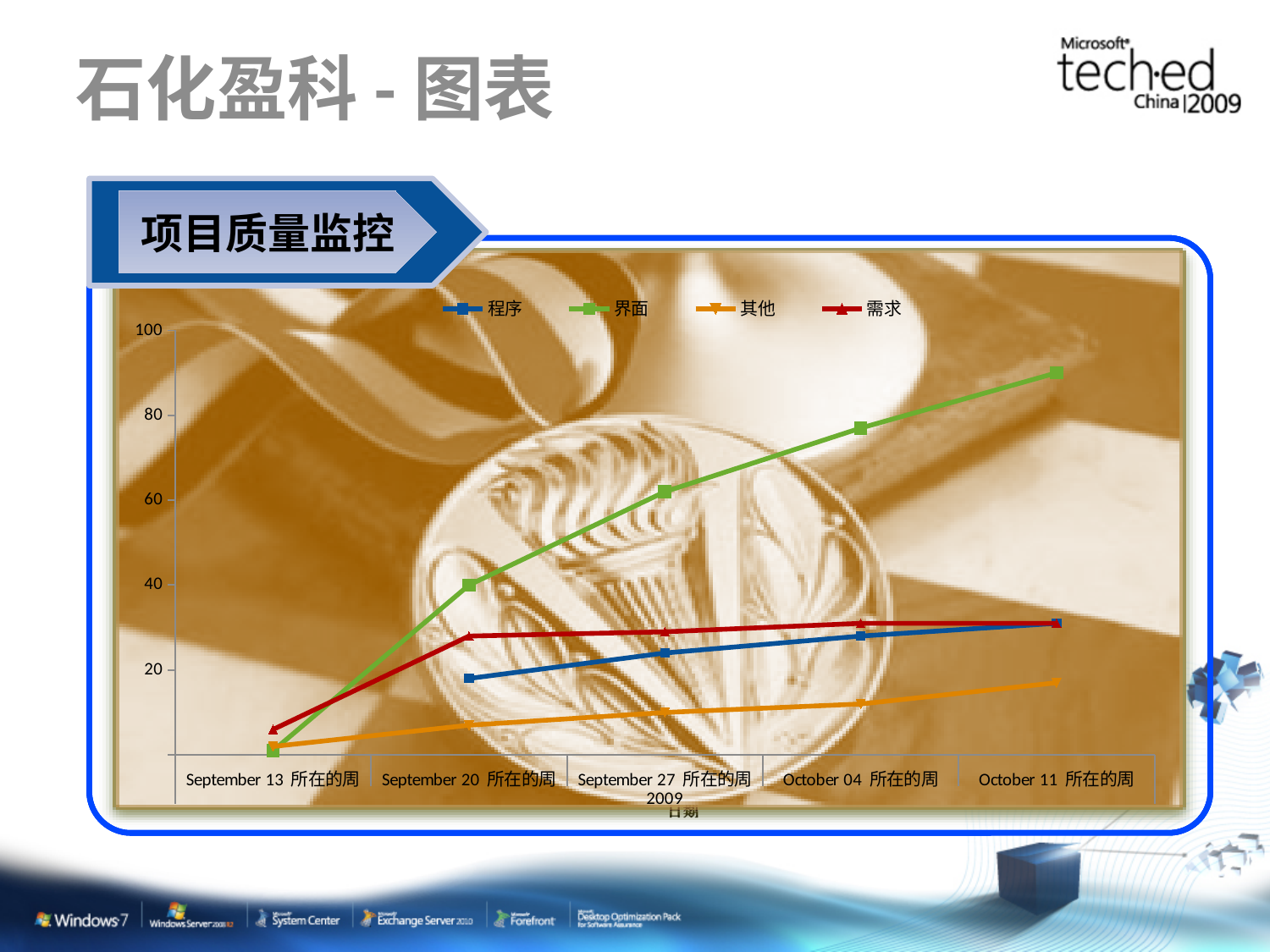
Which is larger in the week of September 20, the value for 需求 or the value for 程序? 需求 What kind of chart is shown on the slide? line chart Does the 界面 series rise or fall from the week of September 13 to the week of October 11? rise How many weeks (categories) are shown along the x axis of the chart? 5 Is the value for 界面 in the week of October 11 greater or less than 80? greater What are the four series names listed in the chart legend? 程序, 界面, 其他, 需求 How many series does the chart legend list? 4 Is the value for 程序 in the week of September 20 greater or less than 40? less Is the value for 其他 in the week of October 11 greater or less than 20? less Which series has the highest value in the week of October 11? 界面 Which series has the lowest value in the week of October 11? 其他